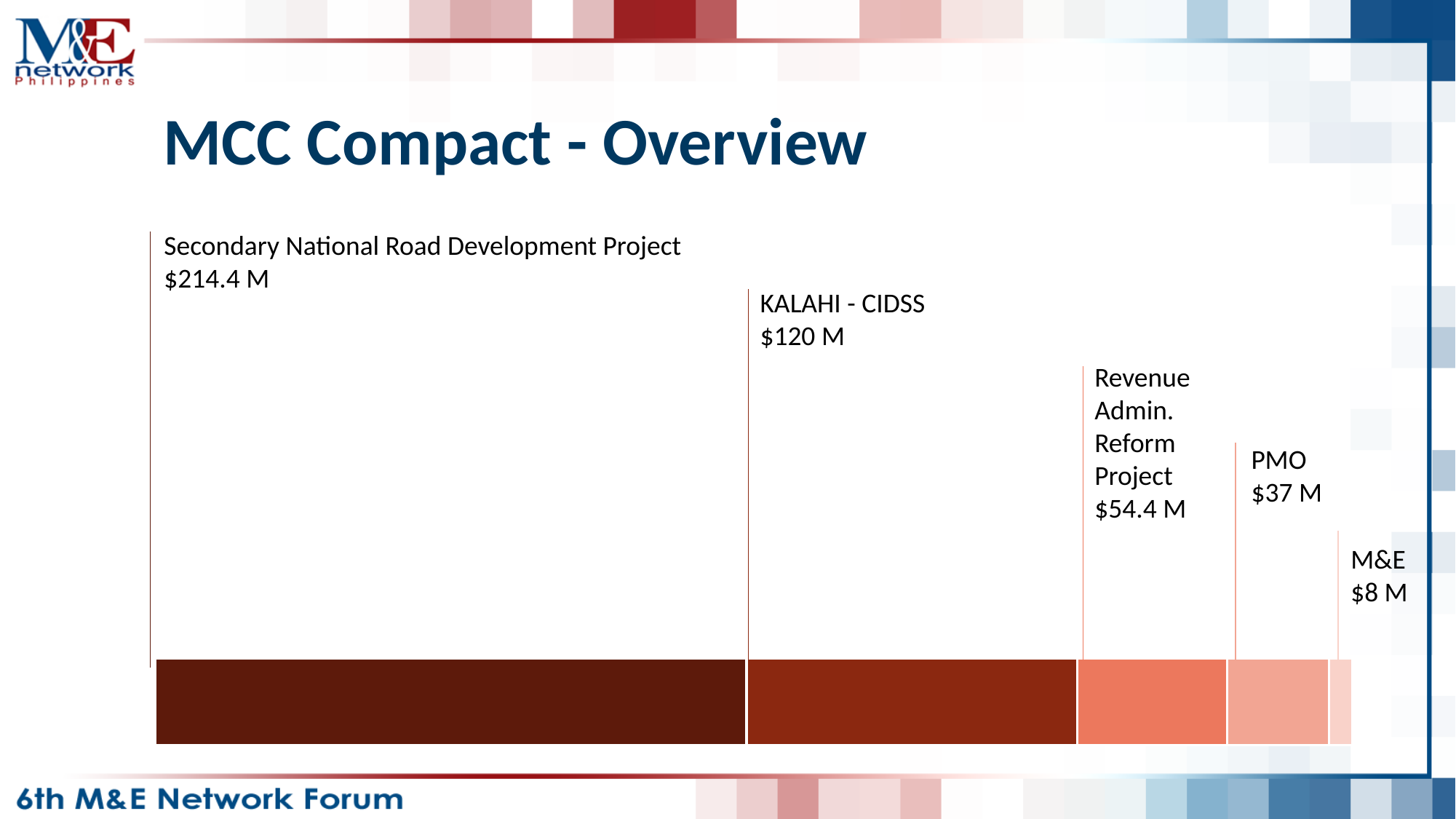
How many components are shown in the bar? 5 What is the value for the Revenue Admin. Reform Project? $54.4 M What is the title of the slide containing the chart? MCC Compact - Overview What is the total of all the segments in the stacked bar? $433.8 M What is the value for M&E? $8 M What is the difference between the Secondary National Road Development Project and KALAHI - CIDSS values? $94.4 M What is the value for KALAHI - CIDSS? $120 M Which component has the largest value? Secondary National Road Development Project Which is larger, the value for PMO or the value for the Revenue Admin. Reform Project? Revenue Admin. Reform Project Which component has the smallest value? M&E What is the value for the Secondary National Road Development Project? $214.4 M What is the value for PMO? $37 M